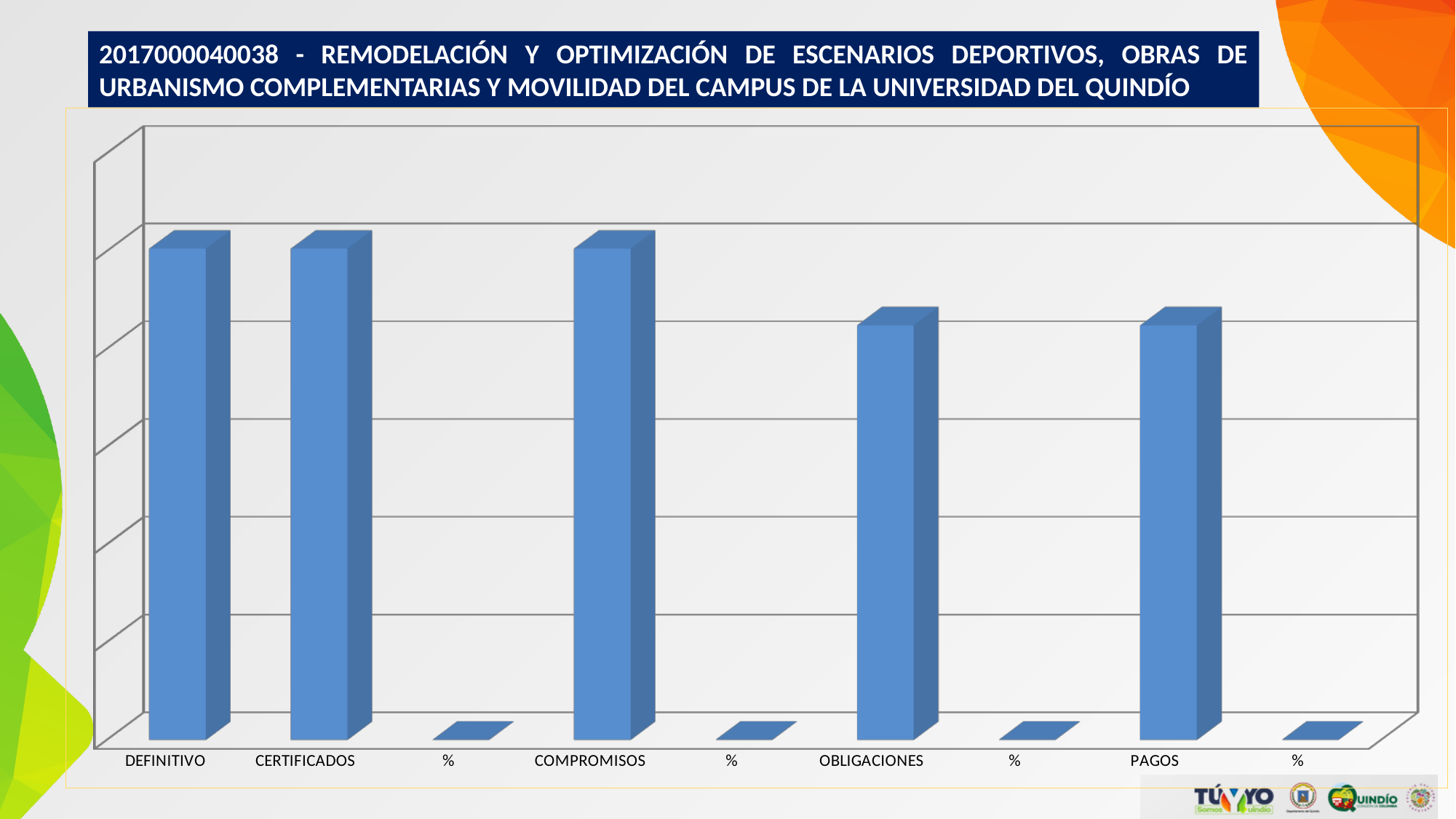
What colour are the bars in the chart? blue Which is larger, the bar for DEFINITIVO or the bar for OBLIGACIONES? DEFINITIVO Which is larger, the bar for COMPROMISOS or the bar for PAGOS? COMPROMISOS How many categories are shown along the x axis of the chart? 9 Which is larger, the bar for OBLIGACIONES or the bar labelled % immediately to its right? OBLIGACIONES What kind of chart is shown on the slide? bar chart What is the label of the first category on the x axis? DEFINITIVO